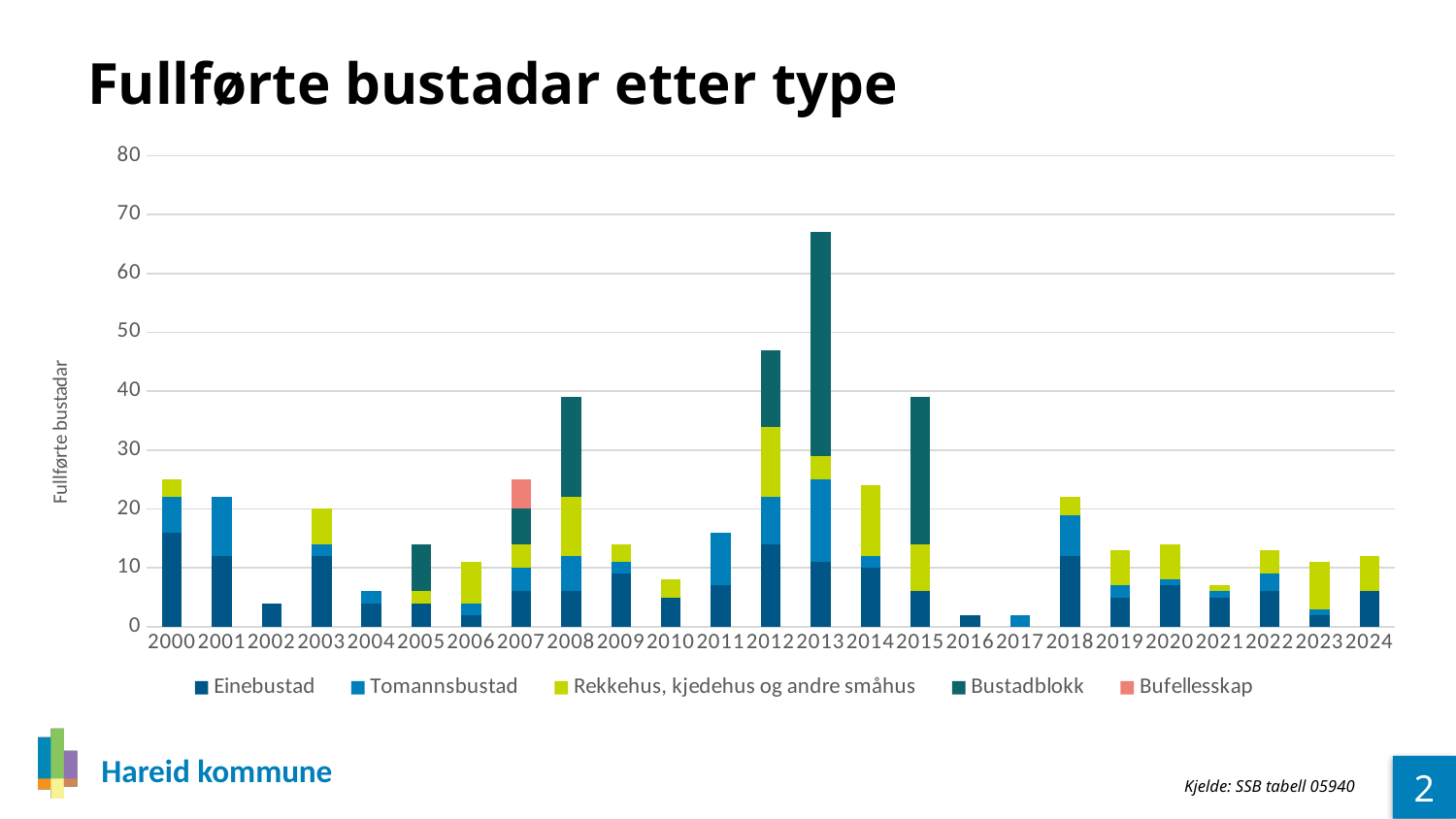
Which year has the larger total, 2012 or 2008? 2012 Which series is shown in pink/red in the legend? Bufellesskap Is the total for 2002 greater or less than 10? less How many series does the legend list? 5 What kind of chart is shown on the slide? Stacked bar chart Is the total for 2012 greater or less than 40? greater Is the total for 2011 greater or less than 20? less What is the title of the chart? Fullførte bustadar etter type Which year has the larger total, 2005 or 2004? 2005 How many years are shown along the x axis? 25 Which year has the highest total of completed dwellings? 2013